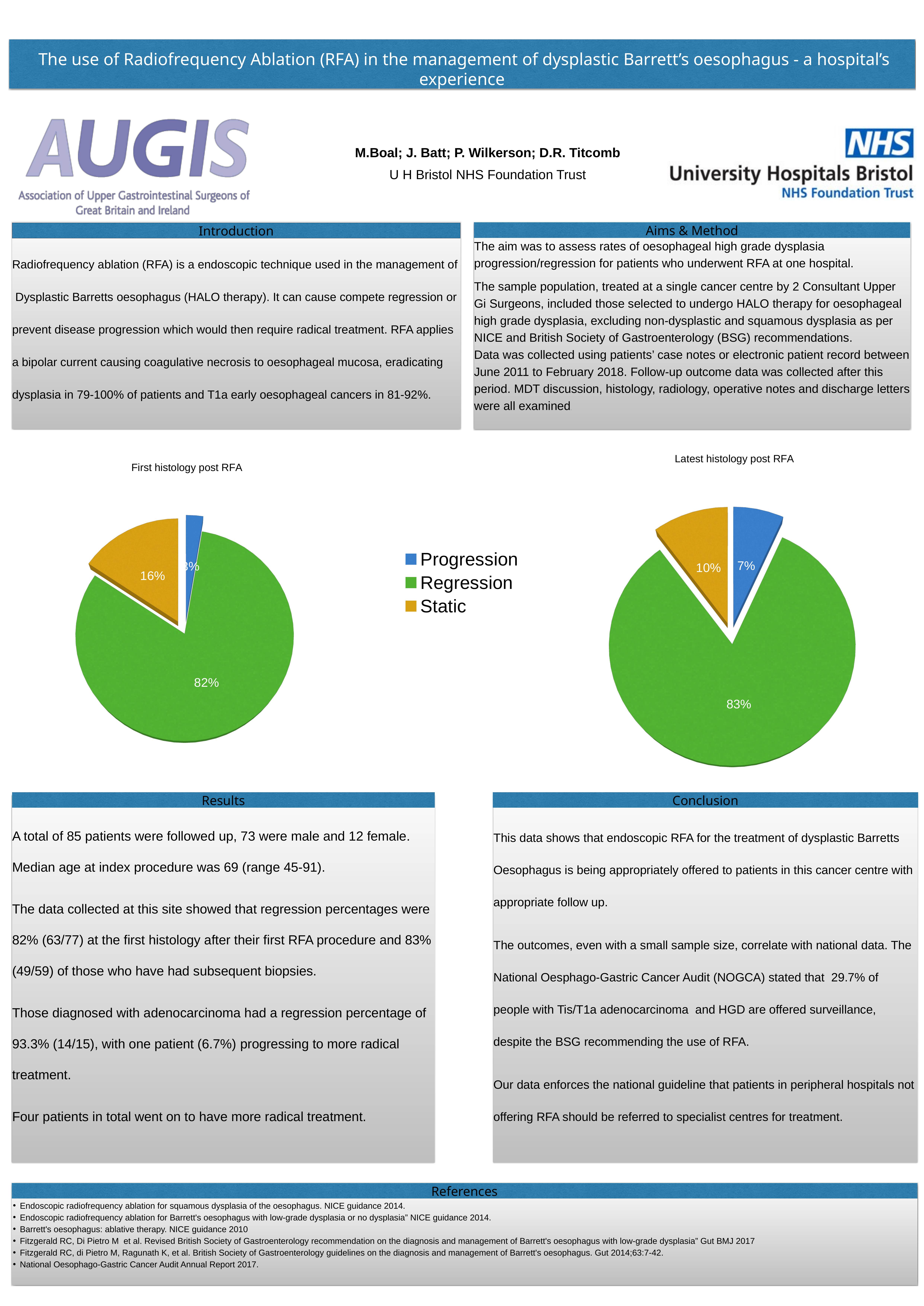
In the "Latest histology post RFA" chart, what is the difference between the Regression and Static shares? 73% In the "Latest histology post RFA" chart, what share of the pie is Static? 10% In the "Latest histology post RFA" chart, what share of the pie is Regression? 83% In the "Latest histology post RFA" chart, which is larger, Static or Progression? Static In the "First histology post RFA" chart, what share of the pie is Regression? 82% How many categories does the legend shared by the two pie charts list? 3 Which colour represents Static in the pie charts? Gold/yellow In the "First histology post RFA" chart, which category has the largest slice? Regression What kind of chart is the "First histology post RFA" chart? Pie chart In the "First histology post RFA" chart, which category has the smallest slice? Progression